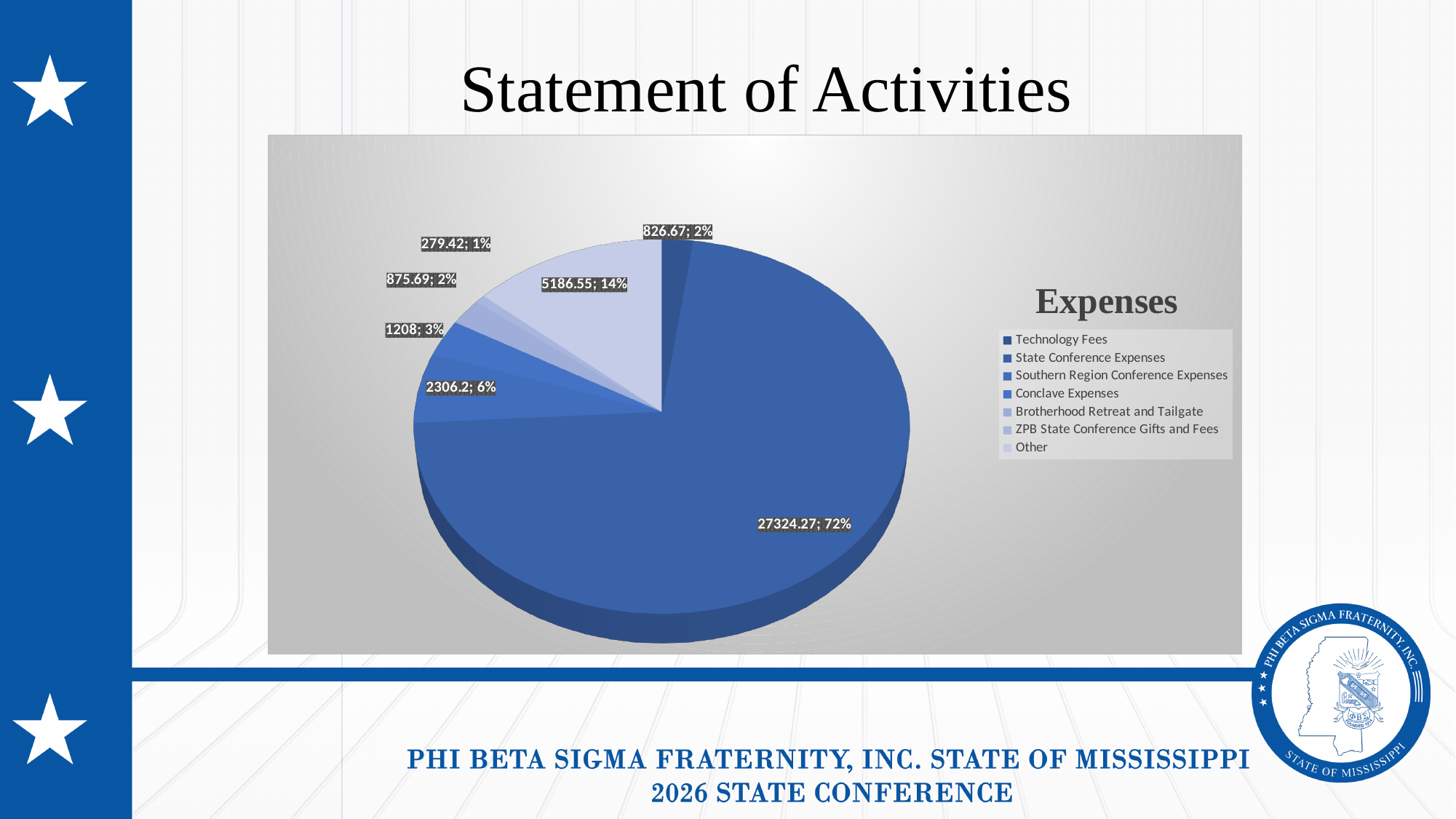
What value is shown for State Conference Expenses? 27324.27 What percentage share of the pie does State Conference Expenses represent? 72% What value is shown for Conclave Expenses? 1208 What is the difference between the Other value and the Southern Region Conference Expenses value? 2880.35 What value is shown for Other in the Expenses chart? 5186.55 Which is larger, Southern Region Conference Expenses or Conclave Expenses? Southern Region Conference Expenses What is the title of the chart? Expenses What kind of chart is shown on the slide? pie chart Which category has the smallest slice in the Expenses pie chart? ZPB State Conference Gifts and Fees How many categories does the legend of the Expenses chart list? 7 What percentage share of the pie does Other represent? 14% Which category has the largest slice in the Expenses pie chart? State Conference Expenses